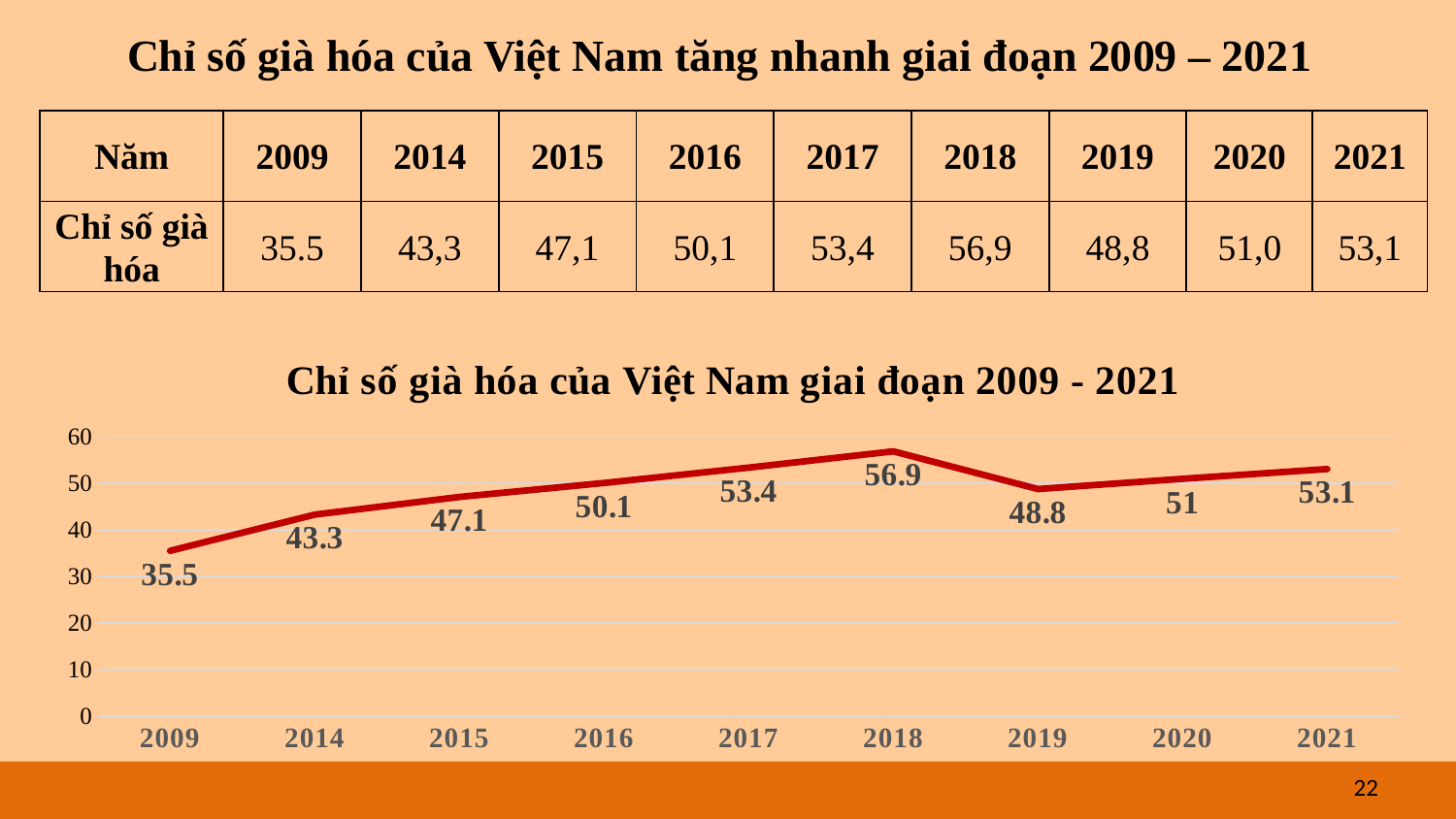
What is the value for 2020 in the chart? 51 What is the difference between the values for 2021 and 2009? 17.6 Which year has the highest value in the chart? 2018 How many years are plotted on the x axis of the chart? 9 What is the value for 2009 in the chart? 35.5 What is the difference between the values for 2018 and 2019? 8.1 Which is larger, the value for 2017 or the value for 2021? 2017 What kind of chart is shown on the slide? line chart Is the value for 2014 greater or less than 40? greater What is the title of the chart? Chỉ số già hóa của Việt Nam giai đoạn 2009 - 2021 What is the value for 2018 in the chart? 56.9 Which year has the lowest value in the chart? 2009